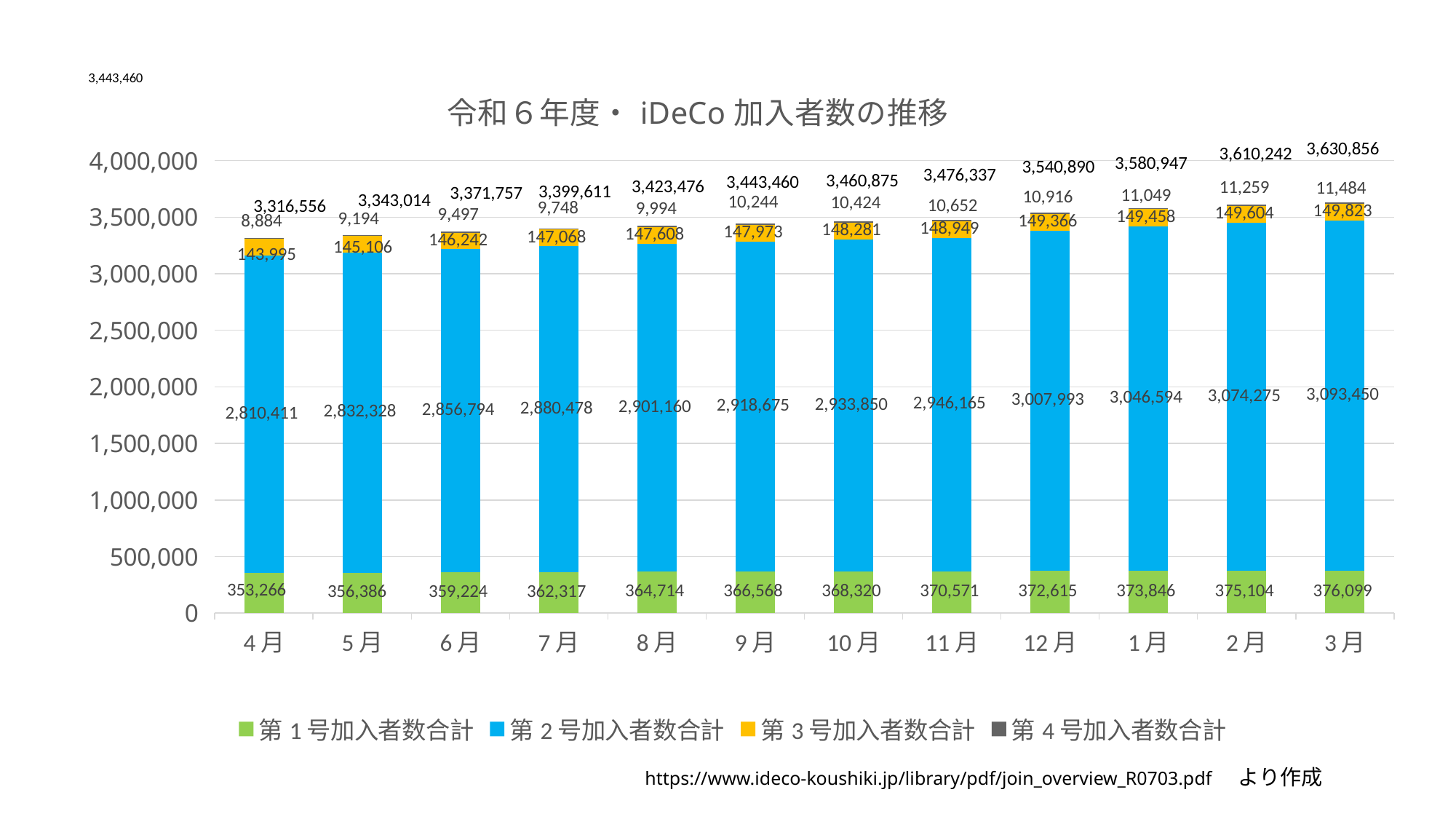
How many months (categories) are shown on the x axis? 12 What is the difference between the 第２号加入者数合計 value for 3月 and for 4月? 283,039 Which month has the highest total number of participants? 3月 What is the value of 第３号加入者数合計 for 9月? 147,973 What is the value of 第４号加入者数合計 for 3月? 11,484 How many series does the legend list? 4 What is the value of 第１号加入者数合計 for 12月? 372,615 What is the total shown above the stacked bar for 10月? 3,460,875 What is the value of 第２号加入者数合計 for 4月? 2,810,411 What is the title of the chart? 令和６年度・ iDeCo 加入者数の推移 Which month has the lowest total number of participants? 4月 What type of chart is shown on the slide? Stacked bar chart